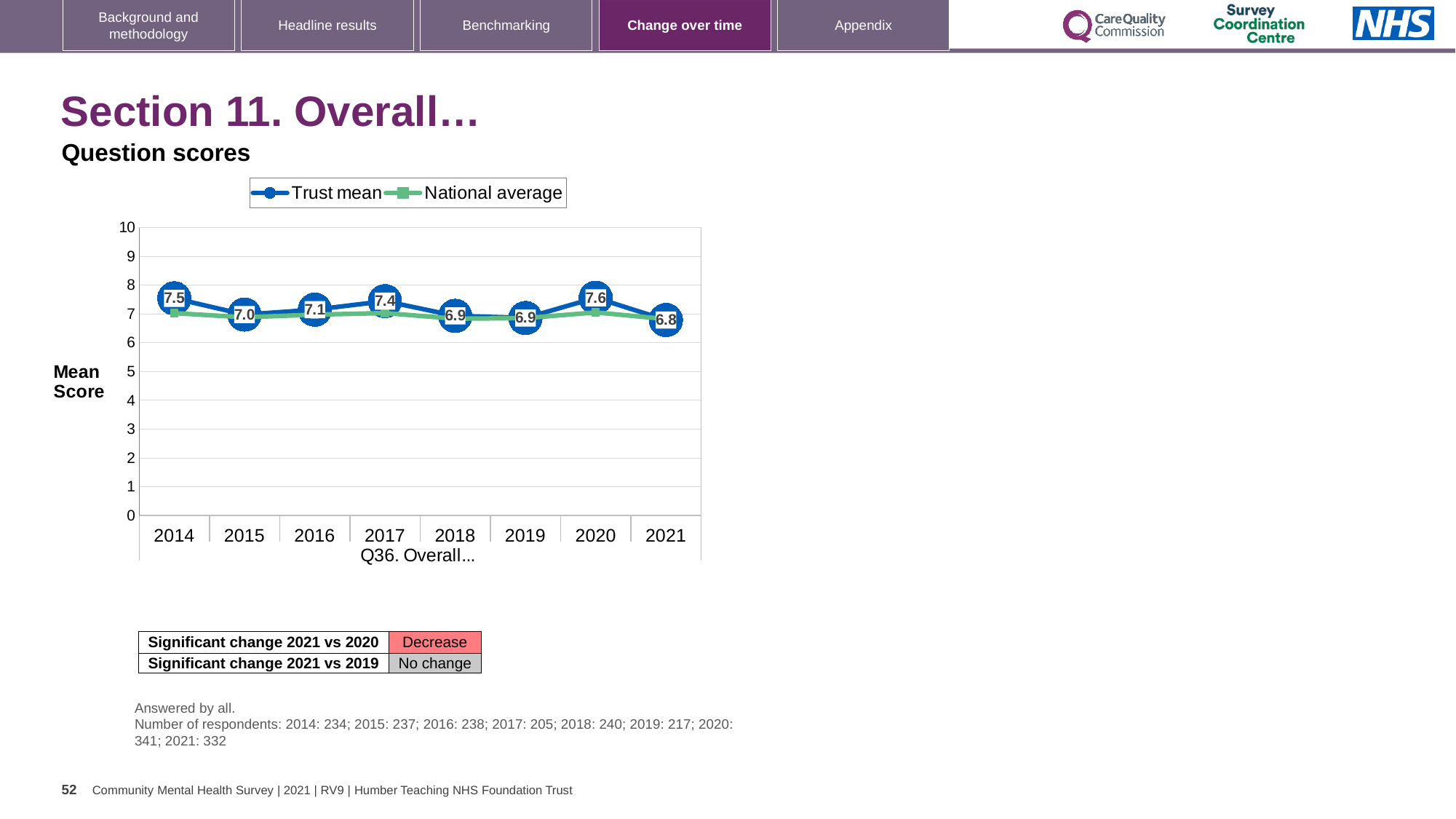
Which year has the larger Trust mean, 2015 or 2017? 2017 In which year is the Trust mean highest? 2020 How many years are shown on the x axis? 8 What is the Trust mean score for 2014? 7.5 How many series does the legend list? 2 What is the difference between the Trust mean in 2020 and in 2021? 0.8 What kind of chart is shown on the slide? Line chart What is the Trust mean score for 2021? 6.8 In which year is the Trust mean lowest? 2021 Is the National average value for 2014 greater or less than 5? greater Does the Trust mean rise or fall from 2020 to 2021? Fall What is the Trust mean score for 2017? 7.4